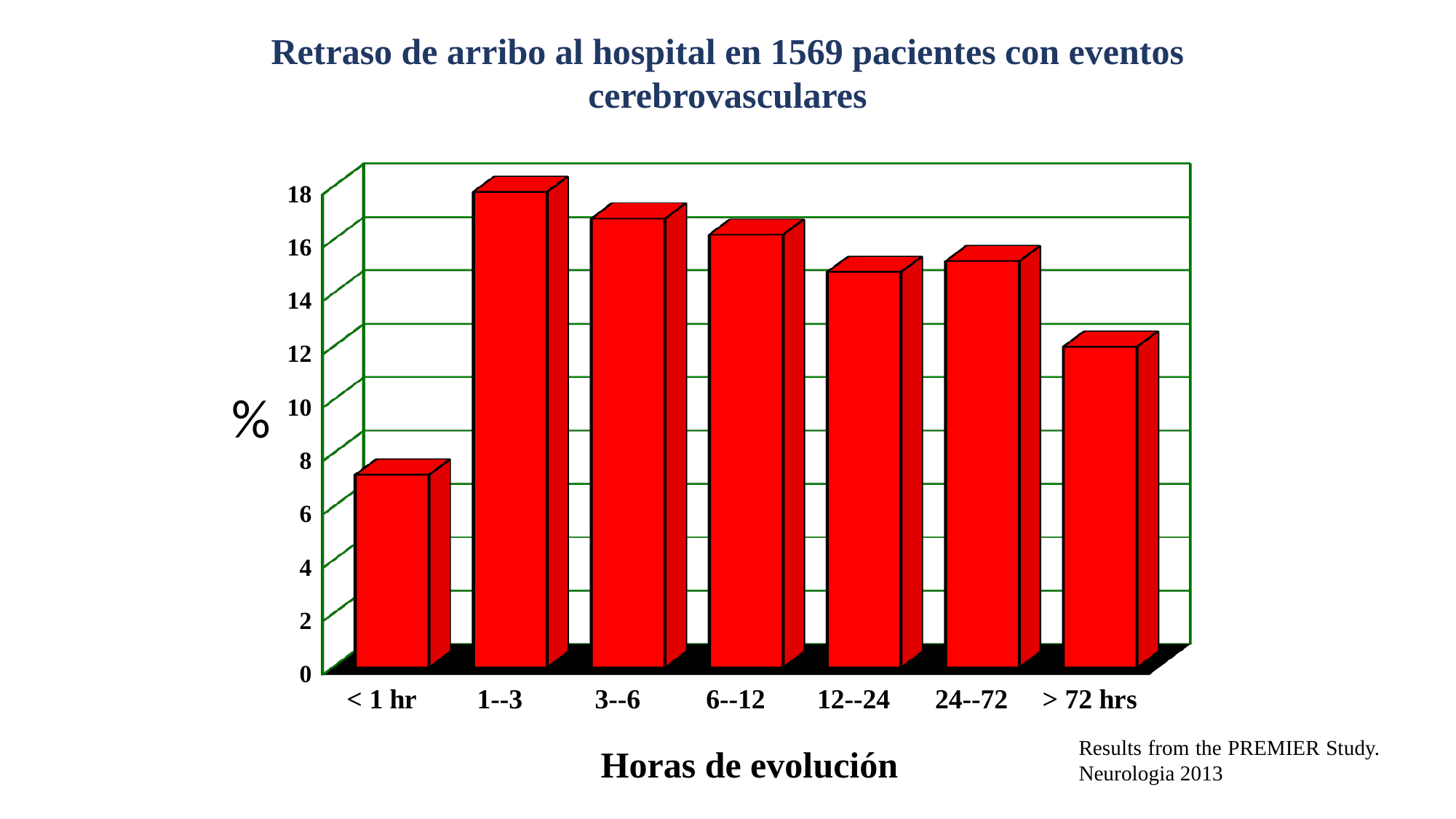
What kind of chart is shown on the slide? Bar chart Which has a larger value, < 1 hr or 6--12? 6--12 Is the value for 3--6 greater or less than 14? greater Is the value for < 1 hr greater or less than 10? less Which time interval has the lowest percentage of patients? < 1 hr What is the label of the x axis? Horas de evolución How many categories (time intervals) are shown on the x axis? 7 Is the value for > 72 hrs greater or less than 14? less Which has a larger value, 1--3 or > 72 hrs? 1--3 Which time interval has the highest percentage of patients? 1--3